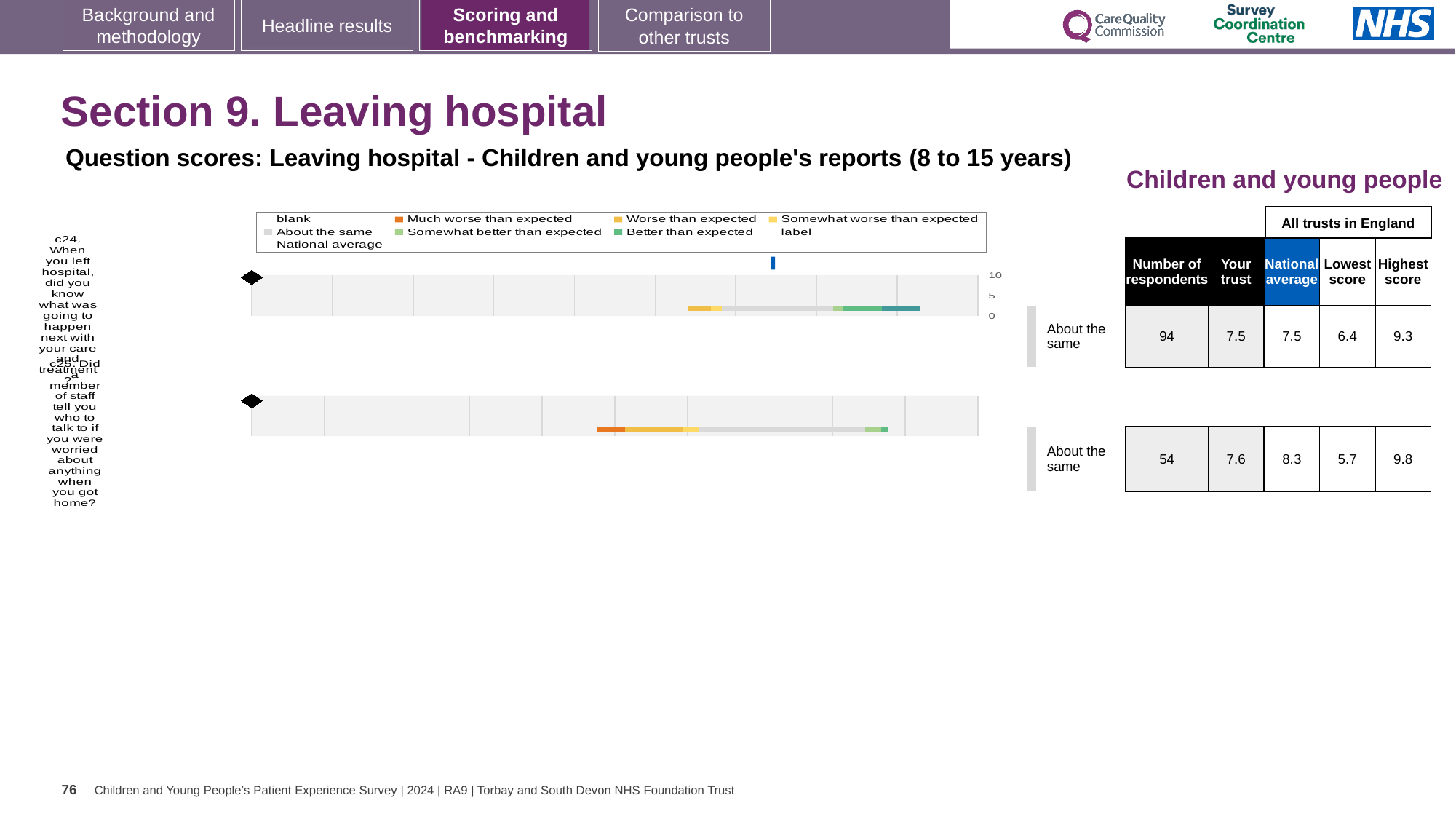
What benchmark category is shown for both c24 and c25? About the same Which question has the larger 'Your trust' score, c24 or c25? c25 What is the difference between the highest and lowest scores for question c24? 2.9 How many survey questions are plotted on the slide? 2 What is the highest score among all trusts in England for question c25? 9.8 For question c25, how much higher is the national average than the 'Your trust' score? 0.7 What kind of chart is used to show the question scores for c24 and c25? bar chart How many respondents answered question c24? 94 Which question has more respondents, c24 or c25? c24 What is the national average score for question c25? 8.3 What is the lowest score among all trusts in England for question c25? 5.7 What is the 'Your trust' score for question c24? 7.5